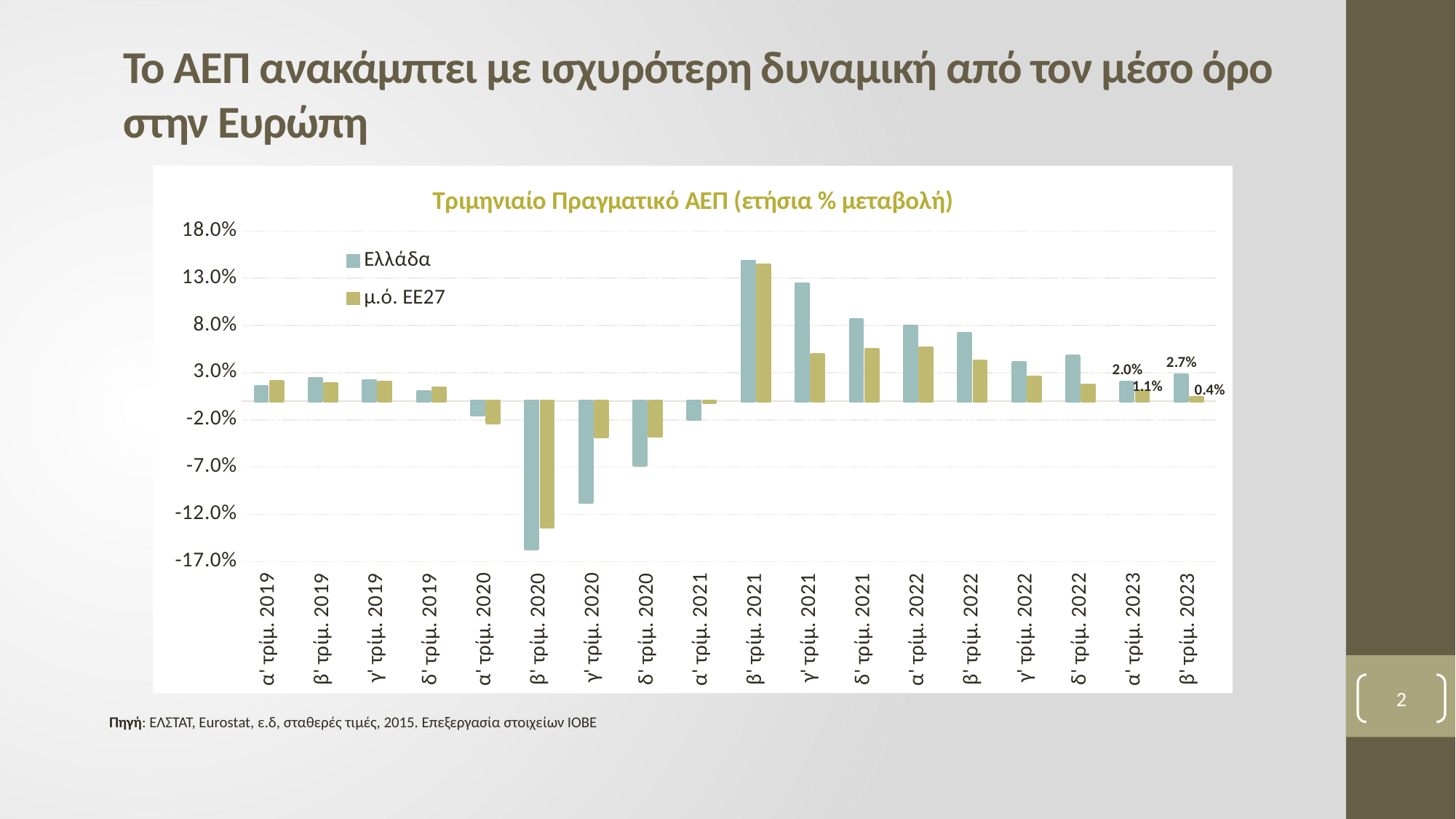
What is the value for μ.ό. ΕΕ27 in β' τριμ. 2023? 0.4% Is the value for Ελλάδα in β' τριμ. 2020 greater or less than -12.0%? less In α' τριμ. 2023, what is the difference between Ελλάδα and μ.ό. ΕΕ27? 0.9 percentage points In β' τριμ. 2023, by how many percentage points does Ελλάδα exceed μ.ό. ΕΕ27? 2.3 percentage points How many series does the legend list? 2 In which quarter does Ελλάδα have its highest value? β' τριμ. 2021 What is the value for μ.ό. ΕΕ27 in α' τριμ. 2023? 1.1% In γ' τριμ. 2021, which series has the larger value, Ελλάδα or μ.ό. ΕΕ27? Ελλάδα What is the value for Ελλάδα in β' τριμ. 2023? 2.7% What is the value for Ελλάδα in α' τριμ. 2023? 2.0% In which quarter does Ελλάδα have its lowest value? β' τριμ. 2020 How many quarters are shown on the x axis? 18